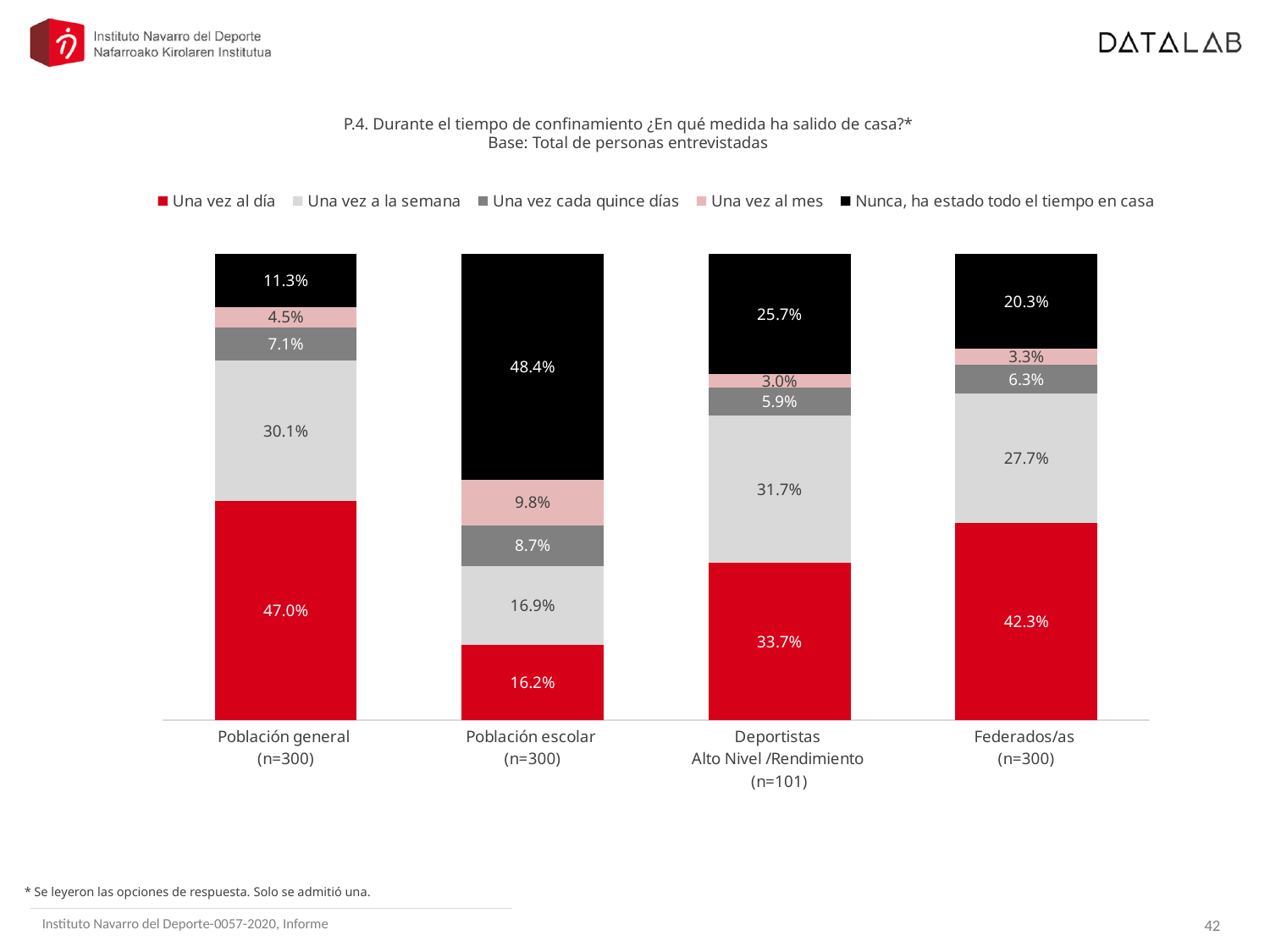
How many categories (bars) are shown on the x axis? 4 What is the value for "Una vez a la semana" for Deportistas Alto Nivel /Rendimiento? 31.7% What is the value for "Nunca, ha estado todo el tiempo en casa" in the Población escolar bar? 48.4% What is the sample size (n) shown for the Deportistas Alto Nivel /Rendimiento category? n=101 What kind of chart is shown on the slide? Stacked bar chart Which category has the lowest value for "Una vez al día"? Población escolar What is the difference between the "Una vez al día" values for Población general and Federados/as? 4.7% Which category has the highest value for "Nunca, ha estado todo el tiempo en casa"? Población escolar How many series does the legend list? 5 Which is larger: "Una vez cada quince días" for Población escolar or for Deportistas Alto Nivel /Rendimiento? Población escolar What is the value for "Una vez al día" in the Población general bar? 47.0% What is the value for "Una vez al mes" for Federados/as? 3.3%